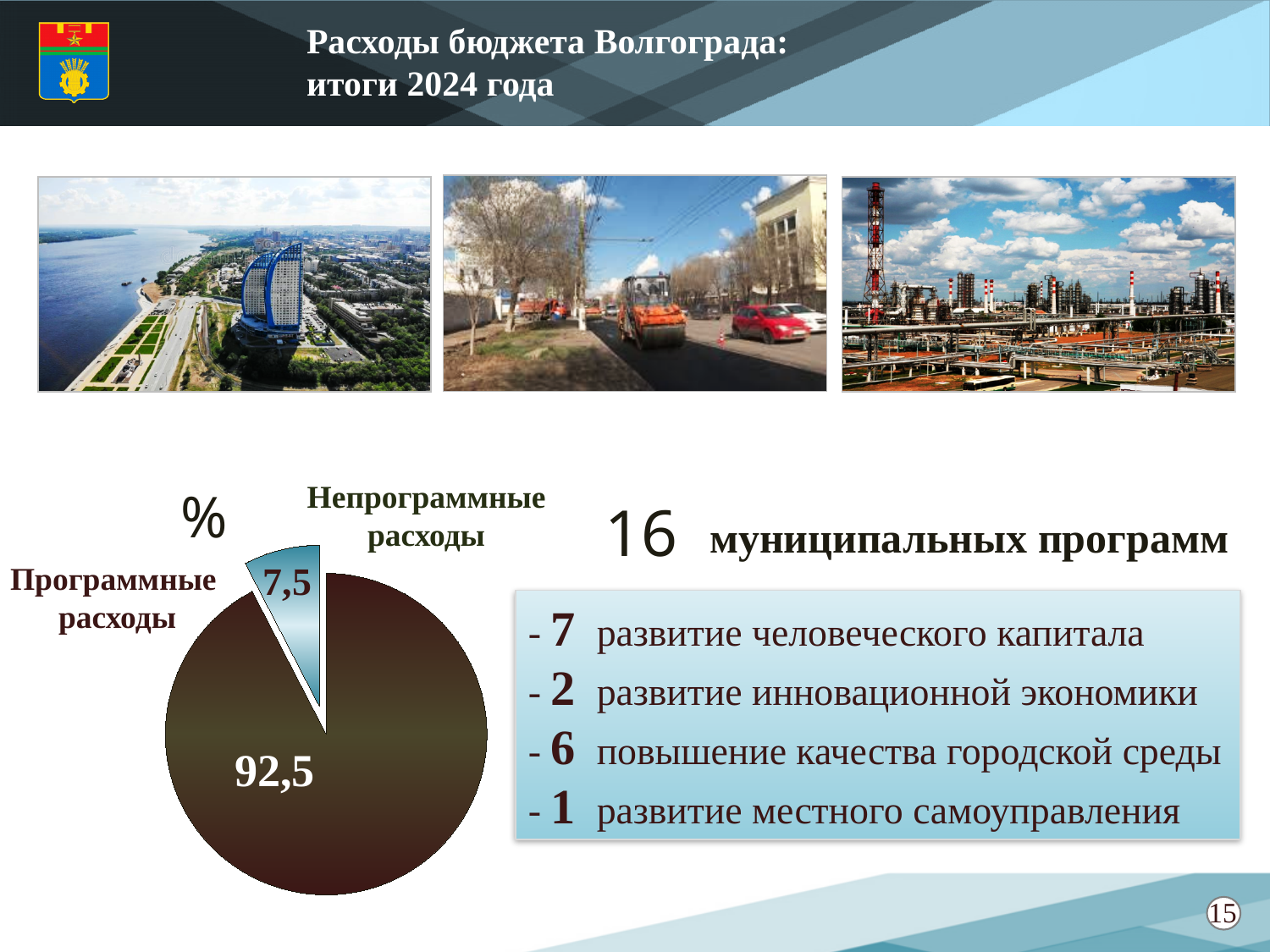
Which slice of the pie chart is the largest? Программные расходы What unit is indicated next to the pie chart? % What kind of chart is shown on the slide? pie chart How many slices does the pie chart have? 2 Which slice of the pie chart is the smallest? Непрограммные расходы What is the difference between the values for Программные расходы and Непрограммные расходы? 85 What is the value for Программные расходы in the pie chart? 92,5 What colour is the Непрограммные расходы slice in the pie chart? light blue Which is larger: Программные расходы or Непрограммные расходы? Программные расходы What is the value for Непрограммные расходы in the pie chart? 7,5 What is the total of the two slices in the pie chart? 100